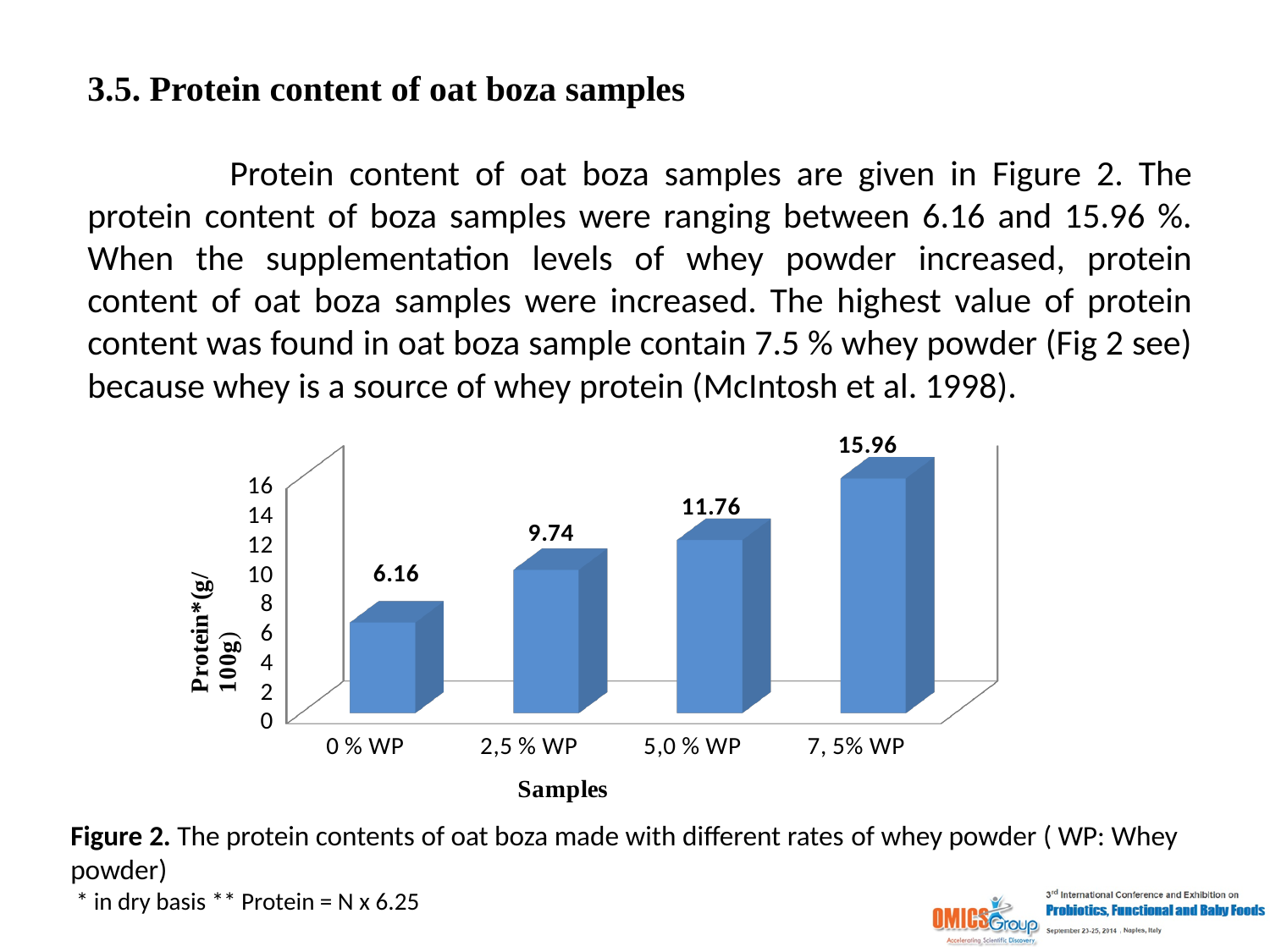
How many samples are shown in the chart? 4 Which sample has the highest protein content? 7, 5% WP Which has a higher protein content, the 2,5 % WP sample or the 5,0 % WP sample? 5,0 % WP What is the difference in protein content between the 5,0 % WP and 2,5 % WP samples? 2.02 What is the difference in protein content between the 7, 5% WP and 0 % WP samples? 9.80 What is the protein content for the 0 % WP sample? 6.16 Do the protein values rise or fall as the whey powder rate increases along the x axis? Rise What kind of chart is shown on the slide? Bar chart What is the protein content for the 2,5 % WP sample? 9.74 What is the protein content for the 7, 5% WP sample? 15.96 Which sample has the lowest protein content? 0 % WP What is the protein content for the 5,0 % WP sample? 11.76